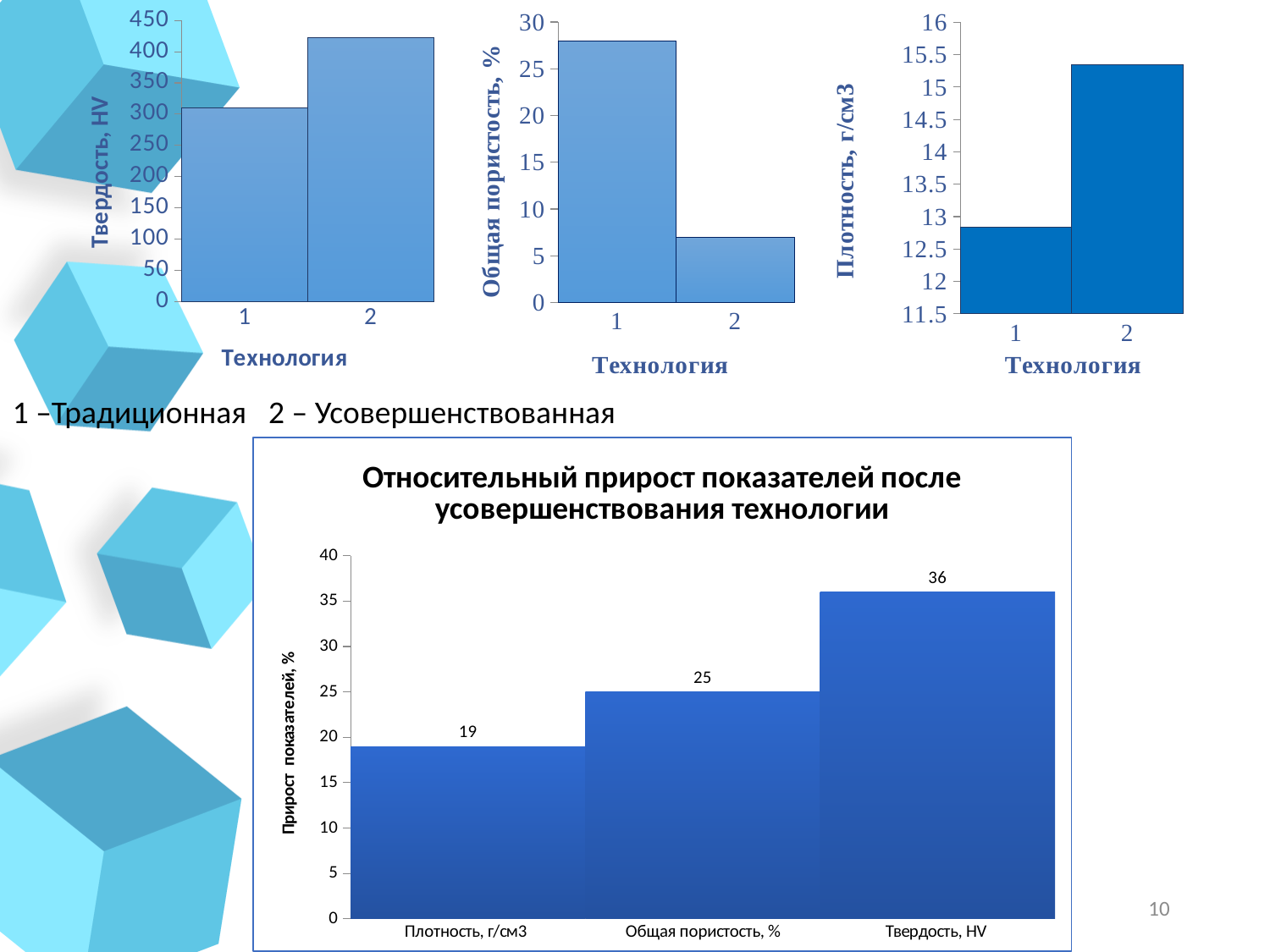
In the bottom chart 'Относительный прирост показателей после усовершенствования технологии', which category has the highest value? Твердость, HV In the top-middle chart (Общая пористость, %), which technology has the larger value, 1 or 2? 1 What kind of chart is the bottom chart 'Относительный прирост показателей после усовершенствования технологии'? bar chart What is the y-axis label of the bottom chart 'Относительный прирост показателей после усовершенствования технологии'? Прирост показателей, % In the bottom chart 'Относительный прирост показателей после усовершенствования технологии', which category has the lowest value? Плотность, г/см3 In the top-middle chart (Общая пористость, %), is the value for Технология 2 greater or less than 10? less In the top-right chart (Плотность, г/см3), is the value for Технология 1 greater or less than 13? less In the bottom chart 'Относительный прирост показателей после усовершенствования технологии', what is the value for Плотность, г/см3? 19 In the bottom chart 'Относительный прирост показателей после усовершенствования технологии', what is the value for Твердость, HV? 36 In the bottom chart 'Относительный прирост показателей после усовершенствования технологии', how many categories are shown? 3 In the top-left chart (Твердость, HV), is the value for Технология 2 greater or less than 400? greater In the bottom chart 'Относительный прирост показателей после усовершенствования технологии', what is the difference between the values for Твердость, HV and Общая пористость, %? 11